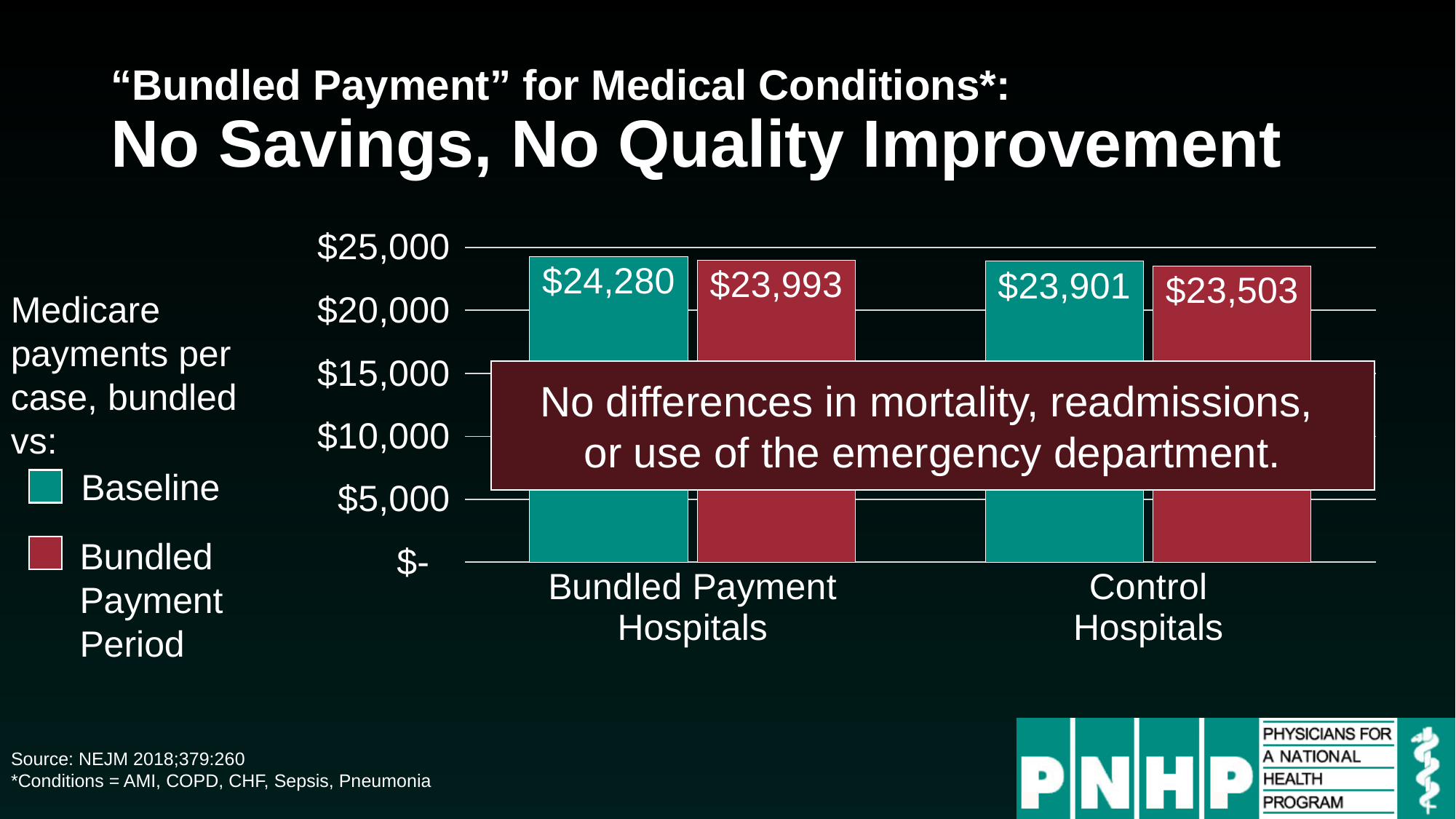
Which bar has the lowest value on the chart? Bundled Payment Period, Control Hospitals Which bar has the highest value on the chart? Baseline, Bundled Payment Hospitals What is the Baseline value for Bundled Payment Hospitals? $24,280 What is the Bundled Payment Period value for Bundled Payment Hospitals? $23,993 What is the difference between the Baseline and Bundled Payment Period values for Bundled Payment Hospitals? $287 Which is larger: the Baseline value for Control Hospitals or the Bundled Payment Period value for Bundled Payment Hospitals? Bundled Payment Period value for Bundled Payment Hospitals What is the Bundled Payment Period value for Control Hospitals? $23,503 How many hospital groups (categories) are shown on the x axis? 2 What is the difference between the Baseline and Bundled Payment Period values for Control Hospitals? $398 How many series does the legend list? 2 What kind of chart is shown on the slide? Bar chart What is the Baseline value for Control Hospitals? $23,901